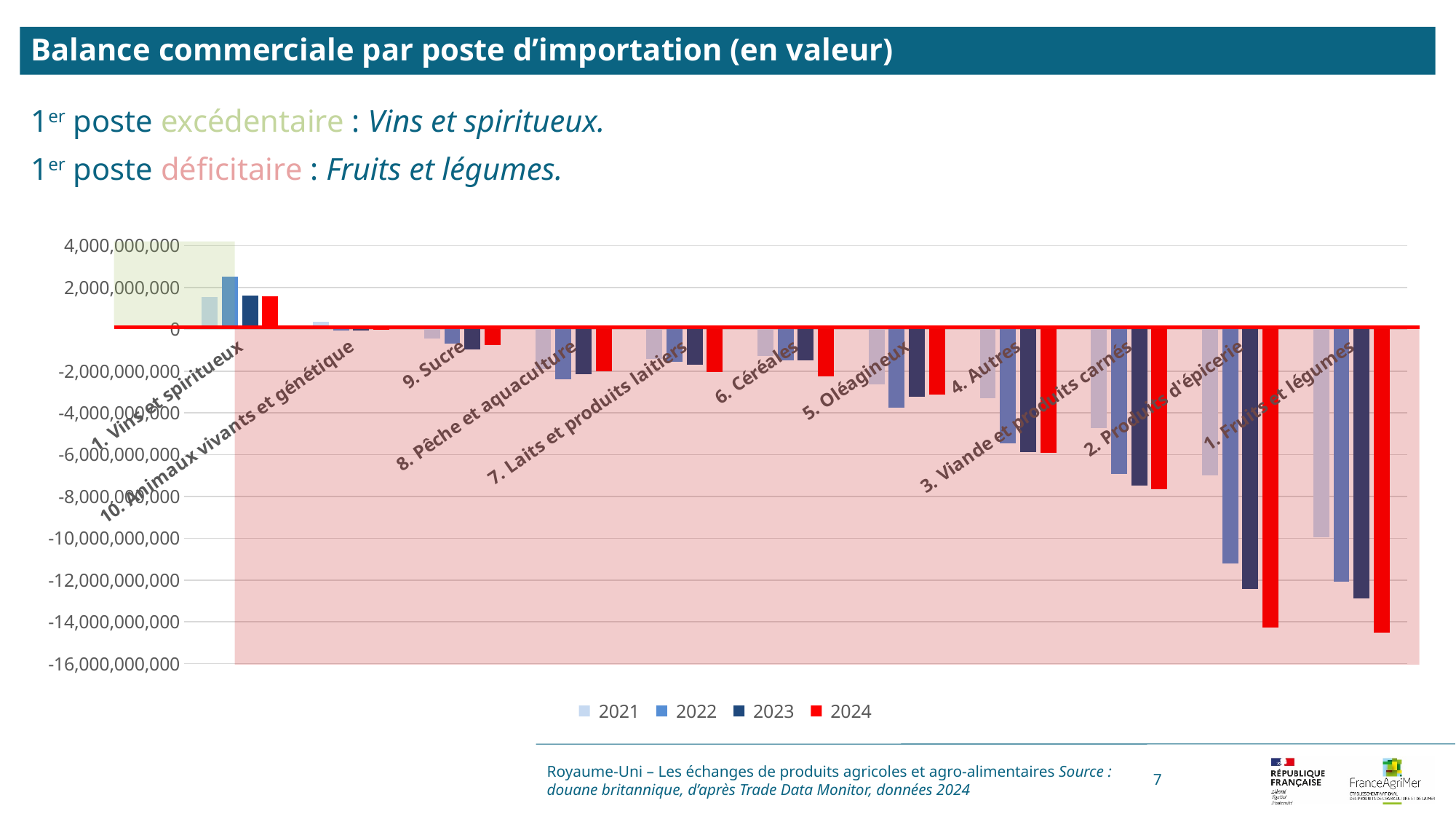
Which has the lower 2024 value: 1. Fruits et légumes or 2. Produits d'épicerie? 1. Fruits et légumes Which category and year has the highest (most positive) value in the chart? 1. Vins et spiritueux, 2022 What kind of chart is shown on the slide? bar chart Is the 2024 value for 1. Fruits et légumes greater or less than -14,000,000,000? less Which category and year has the lowest (most negative) value in the chart? 1. Fruits et légumes, 2024 Is the 2024 value for 2. Produits d'épicerie greater or less than -6,000,000,000? less How many series does the legend list? 4 Which colour represents the 2024 series in the legend? red What is the title of the slide containing the chart? Balance commerciale par poste d'importation (en valeur) Is the 2022 value for 1. Vins et spiritueux greater or less than 2,000,000,000? greater For 1. Fruits et légumes, do the values rise or fall from 2021 to 2024? fall How many product categories are plotted on the x axis? 11